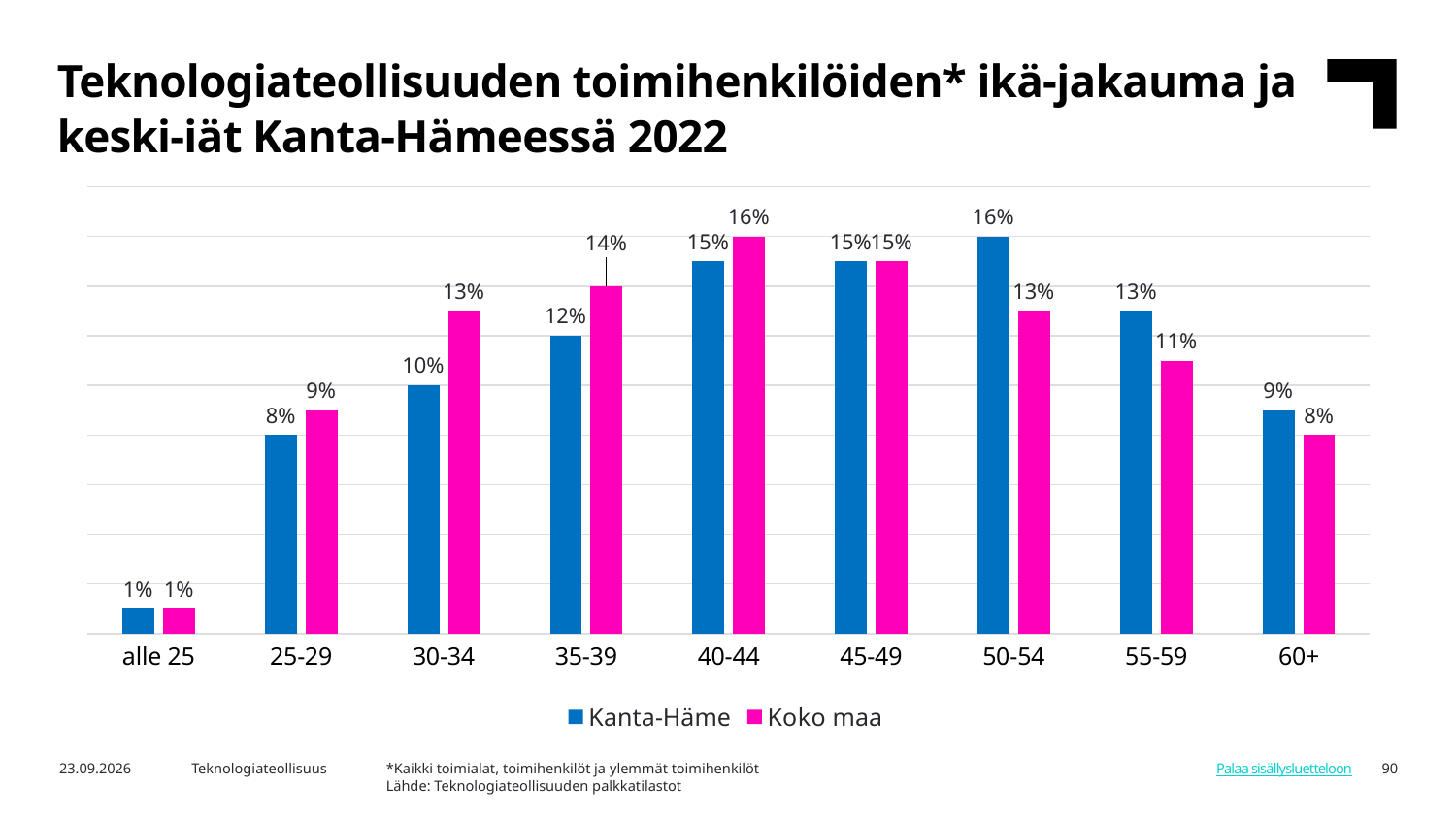
How many series does the legend list? 2 What kind of chart is shown on the slide? bar chart What is the difference between Koko maa and Kanta-Häme in the 30-34 age group? 3% How many age categories are shown on the x axis? 9 In the 55-59 age group, which series has the larger value, Kanta-Häme or Koko maa? Kanta-Häme Which age group has the lowest value for Koko maa? alle 25 Which series is shown in pink in the legend? Koko maa Which age group has the highest value for Kanta-Häme? 50-54 What is the value for Kanta-Häme in the 50-54 age group? 16% What is the value for Koko maa in the 30-34 age group? 13% What is the value for Kanta-Häme in the 60+ age group? 9% Which age group has the highest value for Koko maa? 40-44